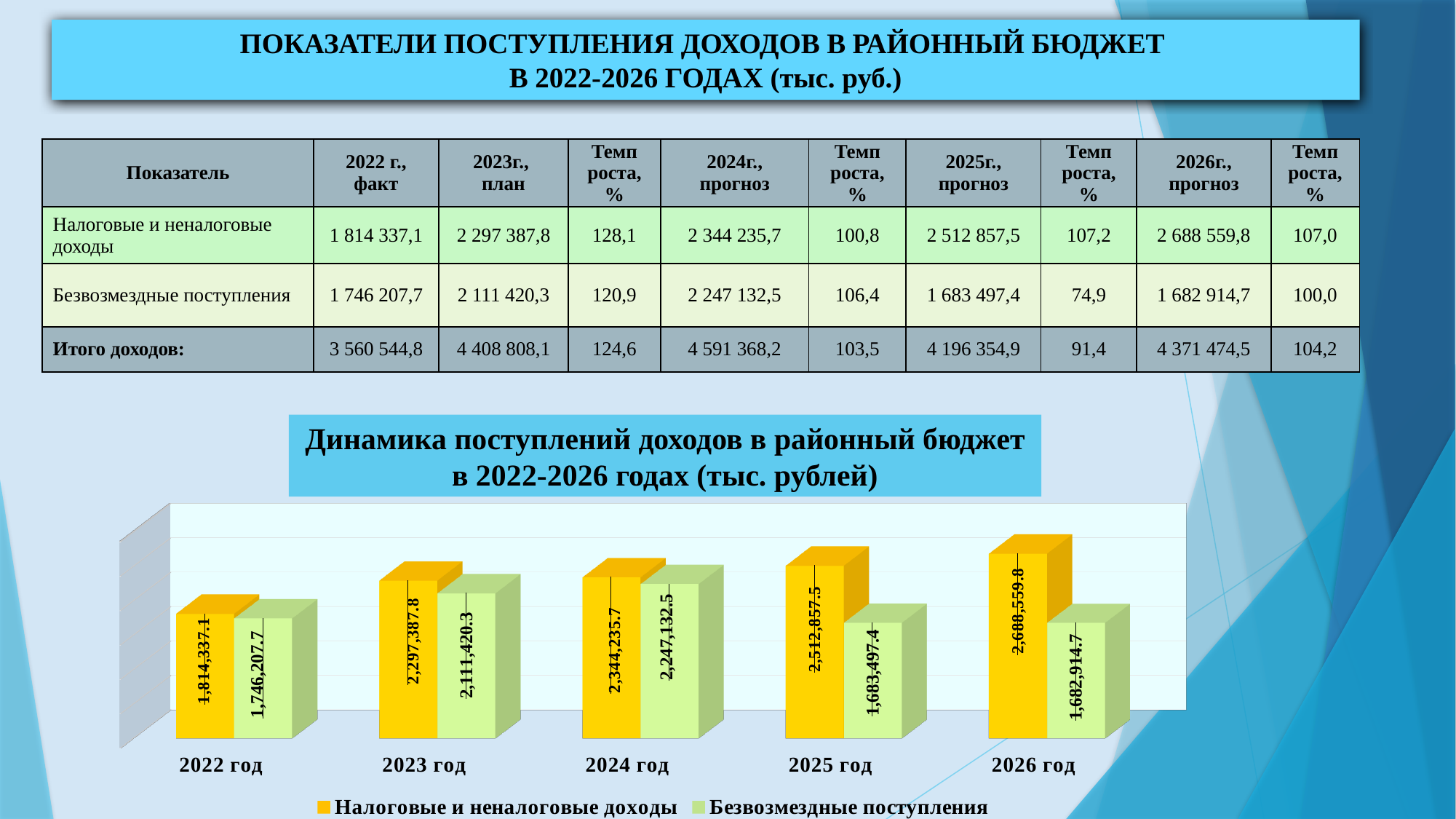
How many year categories are shown on the chart's x axis? 5 What is the title of the chart? Динамика поступлений доходов в районный бюджет в 2022-2026 годах (тыс. рублей) How many series does the chart legend list? 2 Do the values of Налоговые и неналоговые доходы rise or fall from 2022 год to 2026 год on the chart? rise What is the value of Налоговые и неналоговые доходы for 2022 год on the chart? 1,814,337.1 In which year is Налоговые и неналоговые доходы highest on the chart? 2026 год What is the value of Безвозмездные поступления for 2025 год on the chart? 1,683,497.4 What kind of chart is shown on the slide? bar chart Which is larger for 2023 год on the chart: Налоговые и неналоговые доходы or Безвозмездные поступления? Налоговые и неналоговые доходы What is the difference between Налоговые и неналоговые доходы and Безвозмездные поступления for 2026 год on the chart? 1,005,645.1 In which year is Безвозмездные поступления highest on the chart? 2024 год What is the value of Безвозмездные поступления for 2024 год on the chart? 2,247,132.5